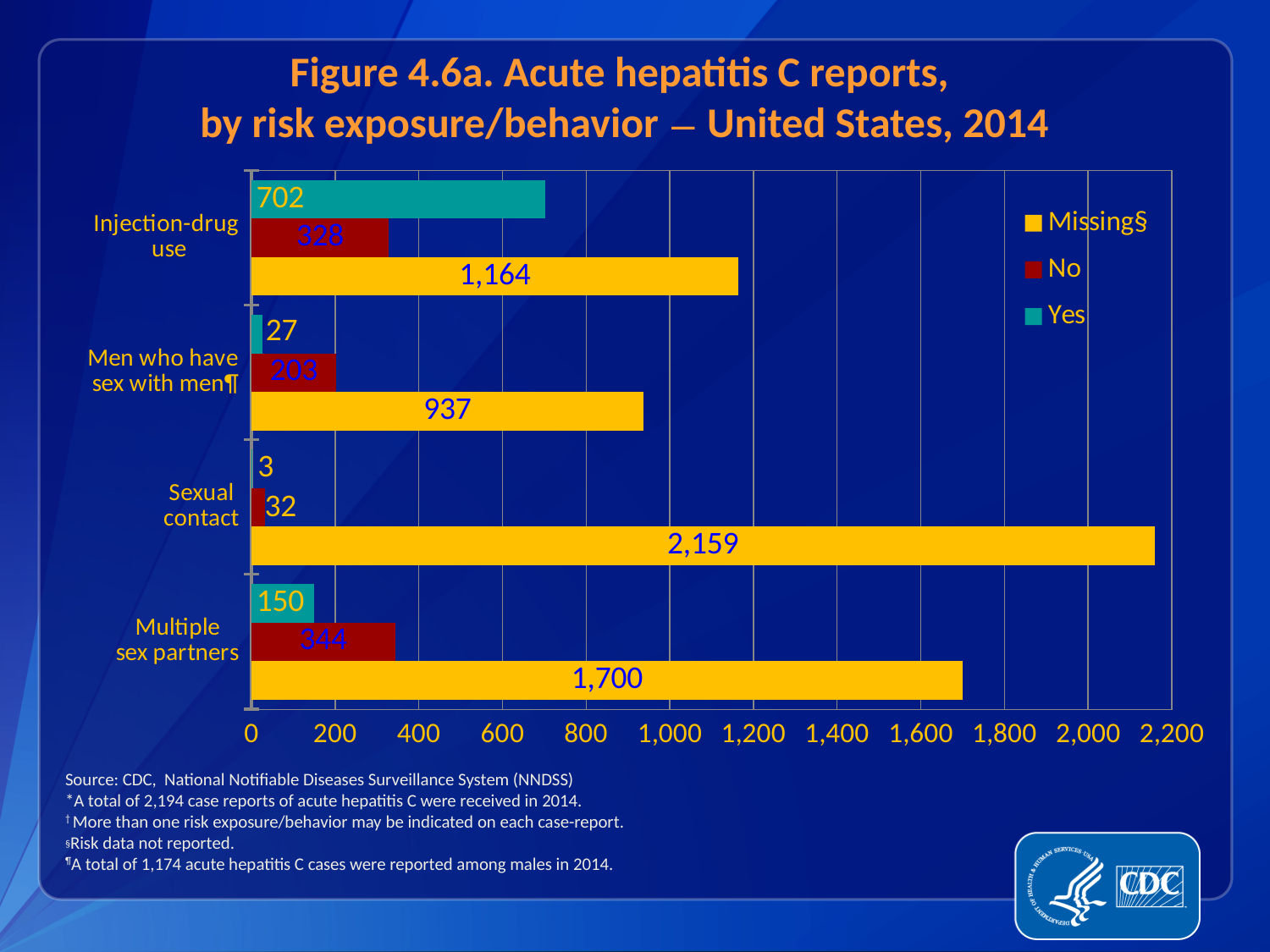
What is the Missing§ value for Multiple sex partners? 1,700 What kind of chart is shown on the slide? bar chart Which risk exposure/behavior has the lowest Yes value? Sexual contact Is the Missing§ value for Men who have sex with men¶ greater or less than 1,000? less Which risk exposure/behavior has the highest Missing§ value? Sexual contact What is the Yes value for Injection-drug use? 702 Which is larger, the Yes value for Injection-drug use or the Yes value for Multiple sex partners? Injection-drug use What is the Missing§ value for Sexual contact? 2,159 How many series does the legend list? 3 What is the Yes value for Men who have sex with men¶? 27 What is the difference between the Missing§ values for Sexual contact and Multiple sex partners? 459 How many risk exposure/behavior categories are shown on the chart? 4